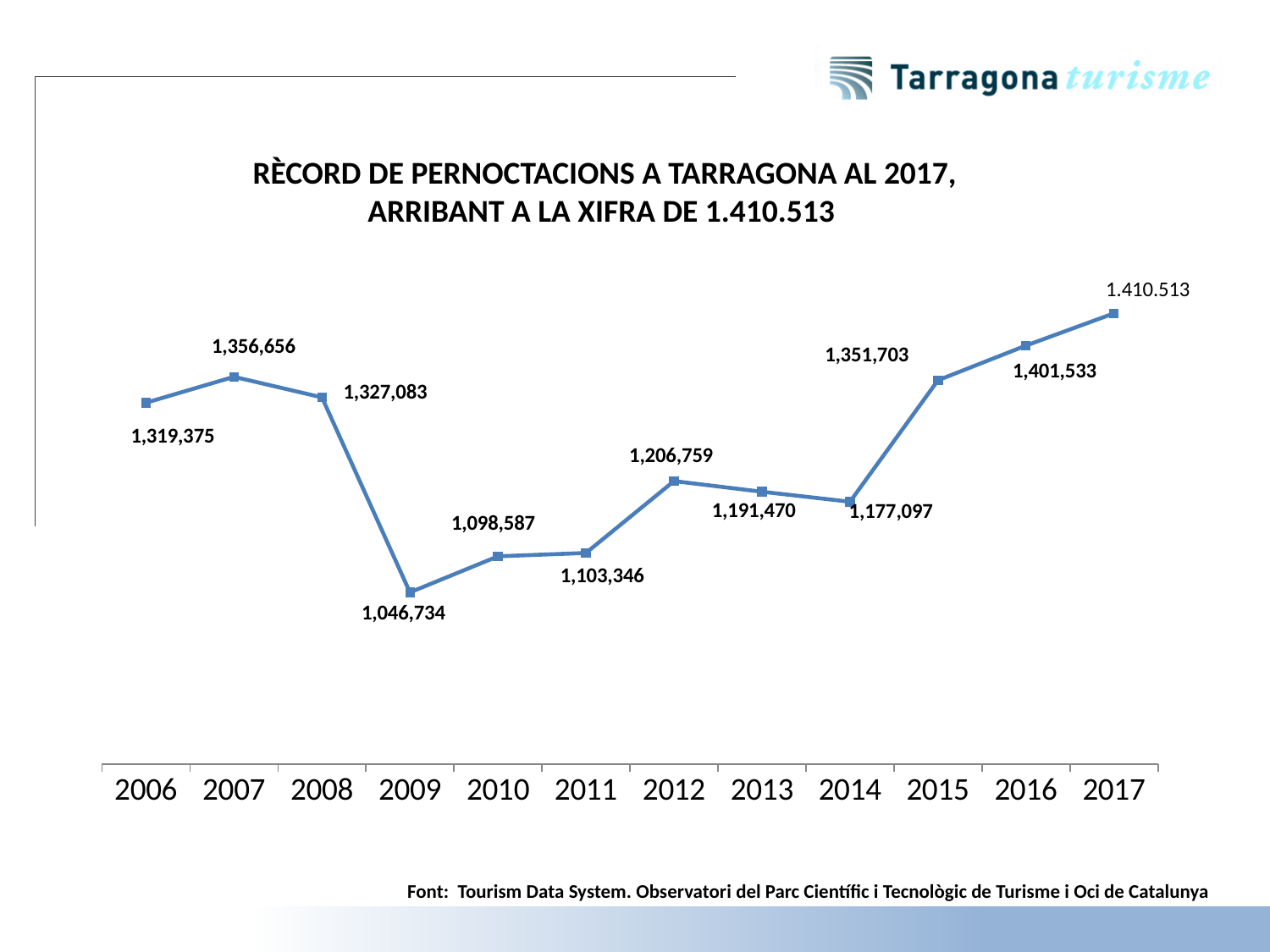
Which is larger, the value for 2013 or the value for 2014? 2013 What is the difference between the values for 2007 and 2006? 37,281 What type of chart is shown on the slide? Line chart Which year has the highest value? 2017 What is the value for 2012? 1,206,759 What is the value for 2006? 1,319,375 How many years are plotted on the x axis? 12 Which year has the lowest value? 2009 Do the values rise or fall from 2014 to 2017? Rise What is the difference between the values for 2008 and 2009? 280,349 What is the value for 2017? 1.410.513 What is the value for 2009? 1,046,734